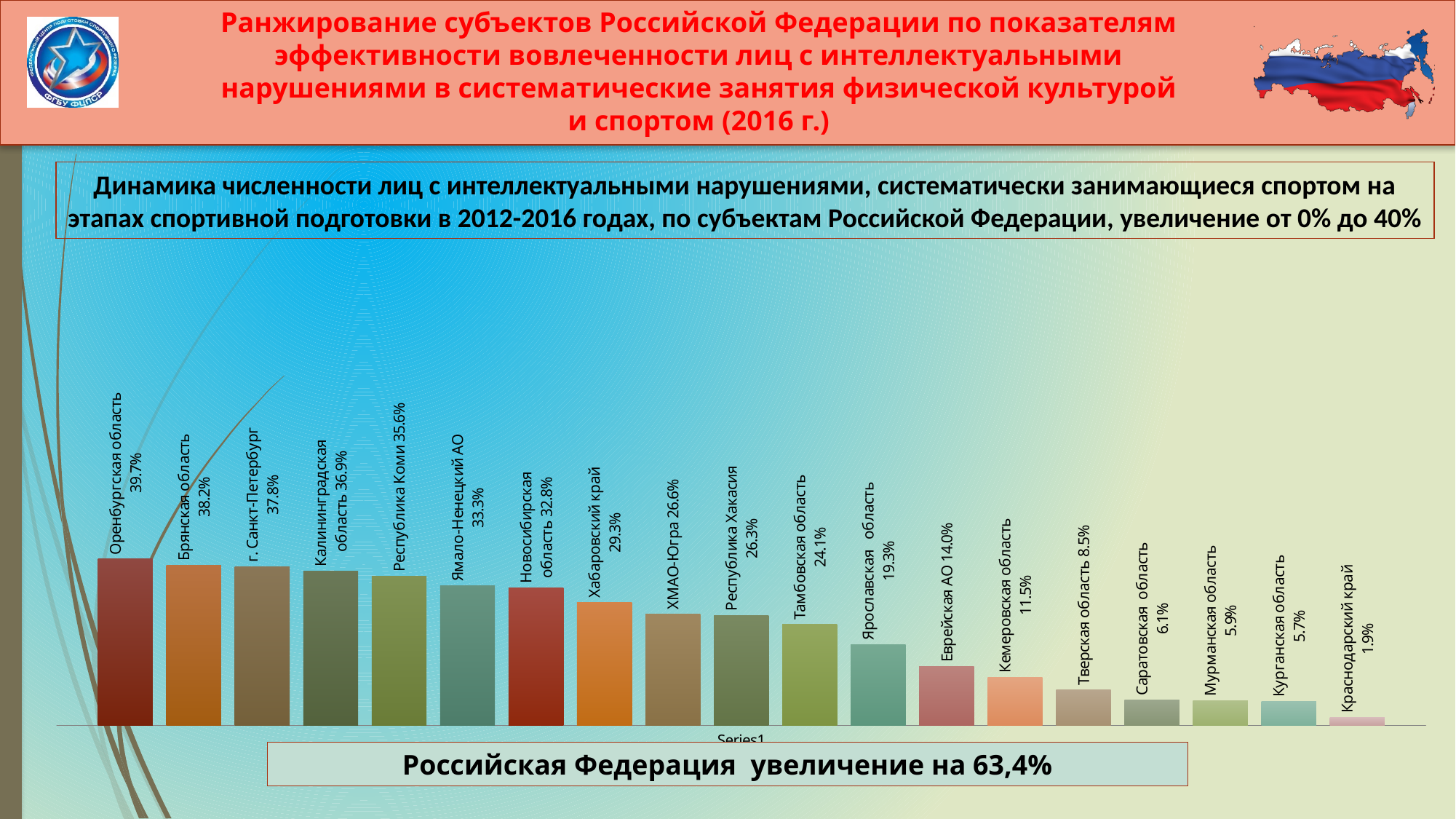
What is the value for Республика Коми? 35.6% Which has a larger value, Ярославская область or Кемеровская область? Ярославская область What is the value for Оренбургская область? 39.7% Which region has the highest value in the chart? Оренбургская область What is the value for Еврейская АО? 14.0% What is the difference between the values for Брянская область and Хабаровский край? 8.9% How many regions (bars) are shown in the chart? 19 What is the value for Тамбовская область? 24.1% Which region has the lowest value in the chart? Краснодарский край What increase for the Российская Федерация is stated in the box below the chart? 63,4% What type of chart is shown on the slide? bar chart Do the values rise or fall from left to right across the chart? fall